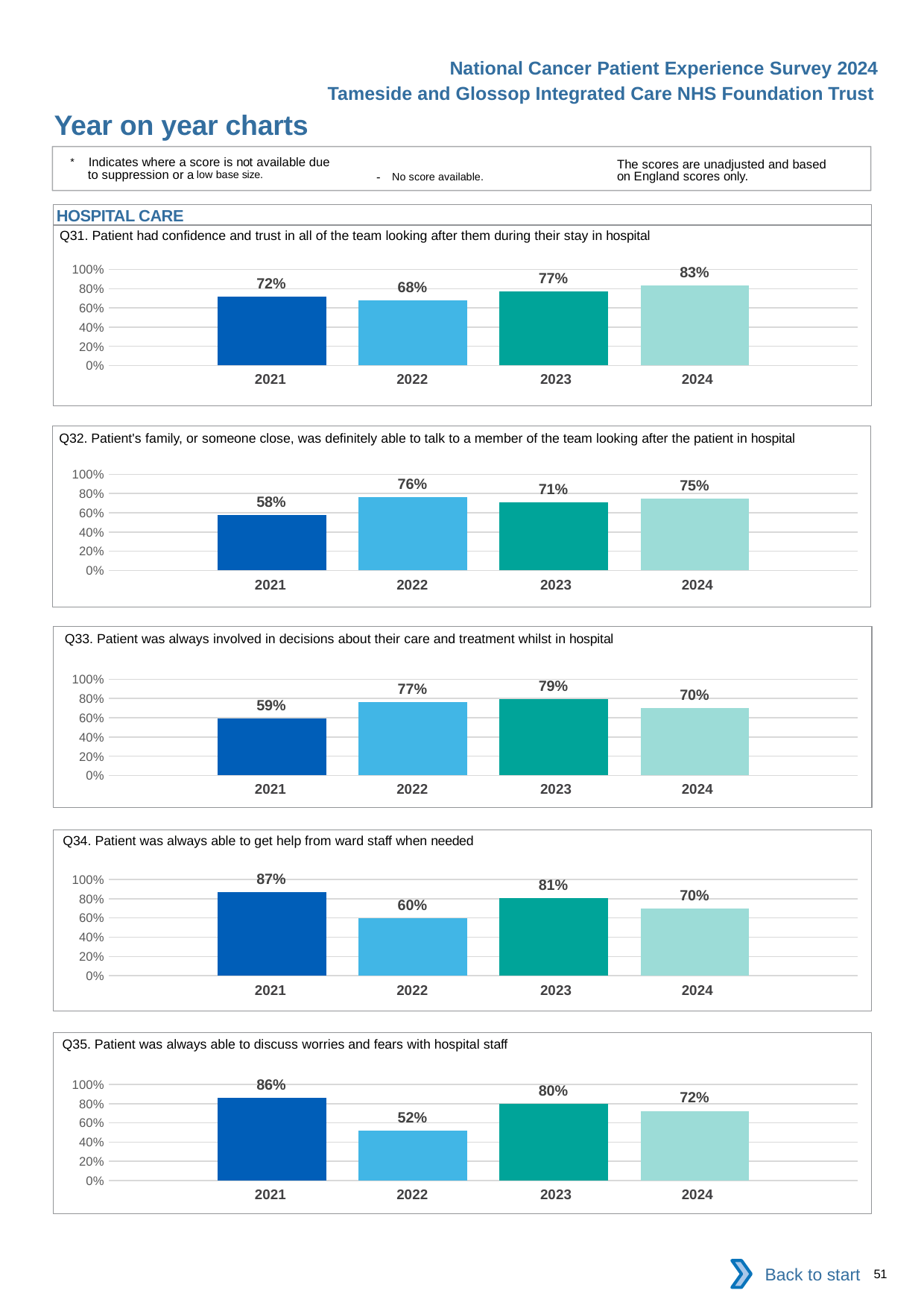
In the Q33 chart, is the value for 2024 greater or less than the value for 2022? less What type of chart is the Q34 chart? Bar chart In the Q31 chart, what is the value for 2024? 83% In the Q31 chart, is the value for 2021 greater or less than 80%? less In the Q32 chart, what is the value for 2021? 58% In the Q35 chart, which year has the lowest value? 2022 In the Q32 chart, what is the difference between the 2022 and 2021 values? 18 percentage points In the Q34 chart, what is the value for 2022? 60% In the Q33 chart, which year has the highest value? 2023 In the Q31 chart, which year has the lowest value? 2022 In the Q35 chart, how many years are plotted? 4 In the Q34 chart, what is the difference between the 2021 and 2024 values? 17 percentage points